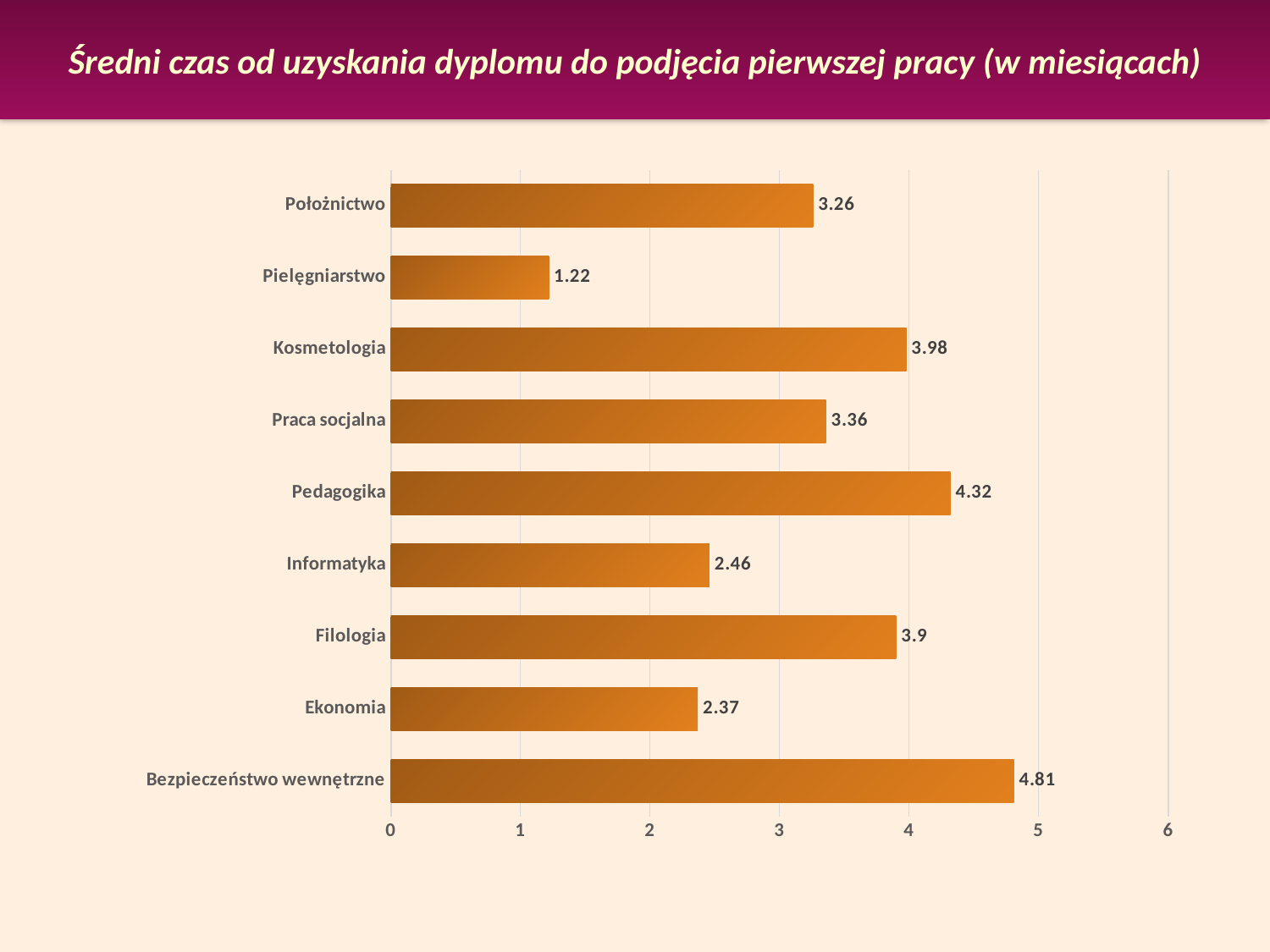
What kind of chart is shown on the slide? bar chart What is the value for Kosmetologia? 3.98 Which category has the highest value? Bezpieczeństwo wewnętrzne What is the value for Ekonomia? 2.37 Is the value for Położnictwo greater or less than 3? greater What is the value for Pielęgniarstwo? 1.22 What is the title of the slide? Średni czas od uzyskania dyplomu do podjęcia pierwszej pracy (w miesiącach) What is the difference between the values for Pedagogika and Informatyka? 1.86 Which category has the lowest value? Pielęgniarstwo How many categories are shown in the chart? 9 What is the difference between the values for Bezpieczeństwo wewnętrzne and Pielęgniarstwo? 3.59 Which is larger, the value for Filologia or the value for Praca socjalna? Filologia